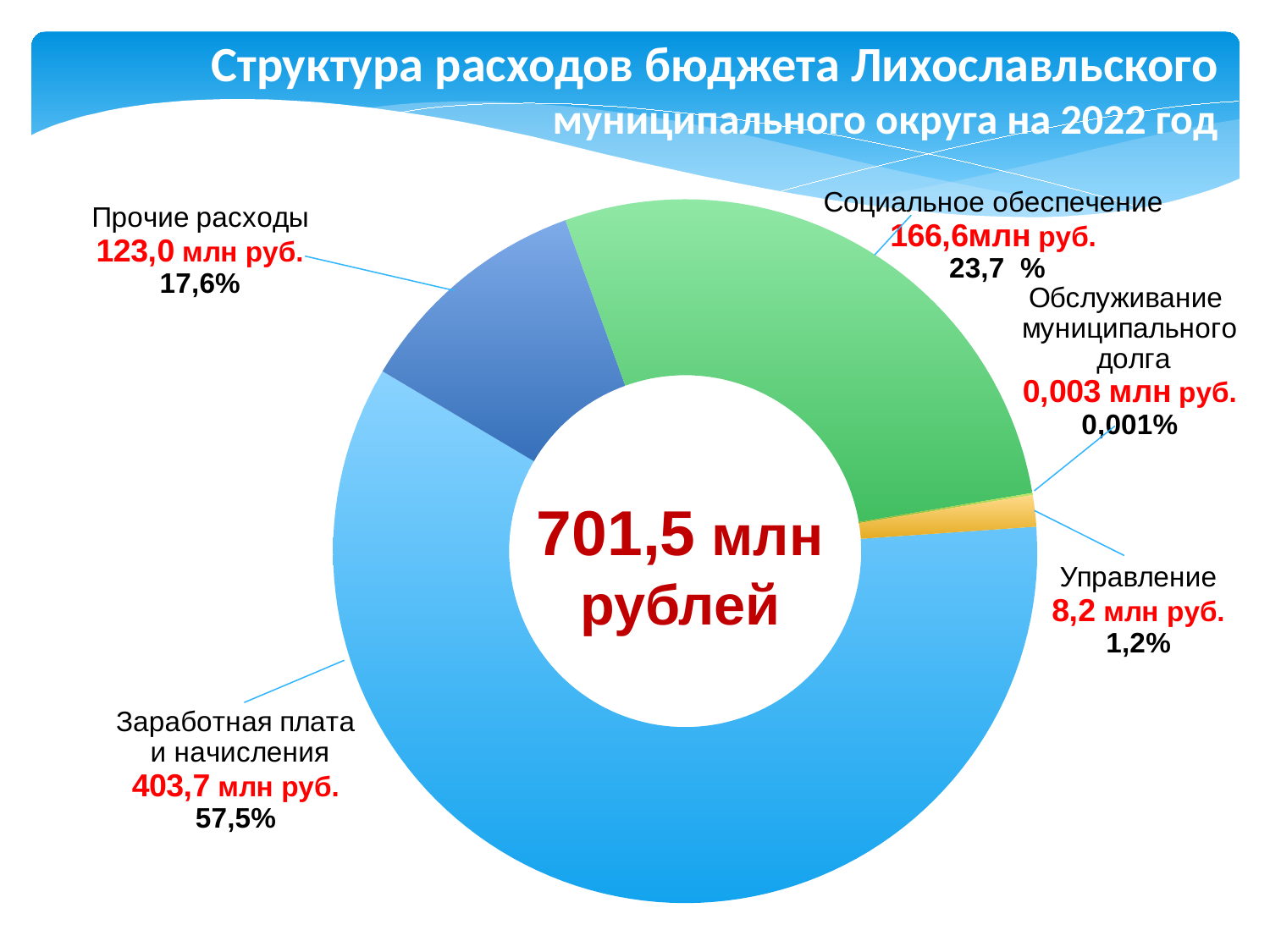
Какова сумма расходов на заработную плату и начисления? 403,7 млн руб. На сколько млн руб. расходы на социальное обеспечение больше прочих расходов? 43,6 млн руб. Какова общая сумма расходов бюджета, указанная в центре диаграммы? 701,5 млн рублей Какова сумма расходов на обслуживание муниципального долга? 0,003 млн руб. Какую долю расходов бюджета составляет социальное обеспечение? 23,7 % Какова сумма расходов на управление? 8,2 млн руб. Какую долю составляют прочие расходы? 17,6% Сколько категорий расходов показано на диаграмме? 5 Какой тип диаграммы показан на слайде? кольцевая (круговая) диаграмма Какая категория расходов является наименьшей? Обслуживание муниципального долга Какая категория расходов является наибольшей? Заработная плата и начисления Что больше: расходы на управление или прочие расходы? Прочие расходы